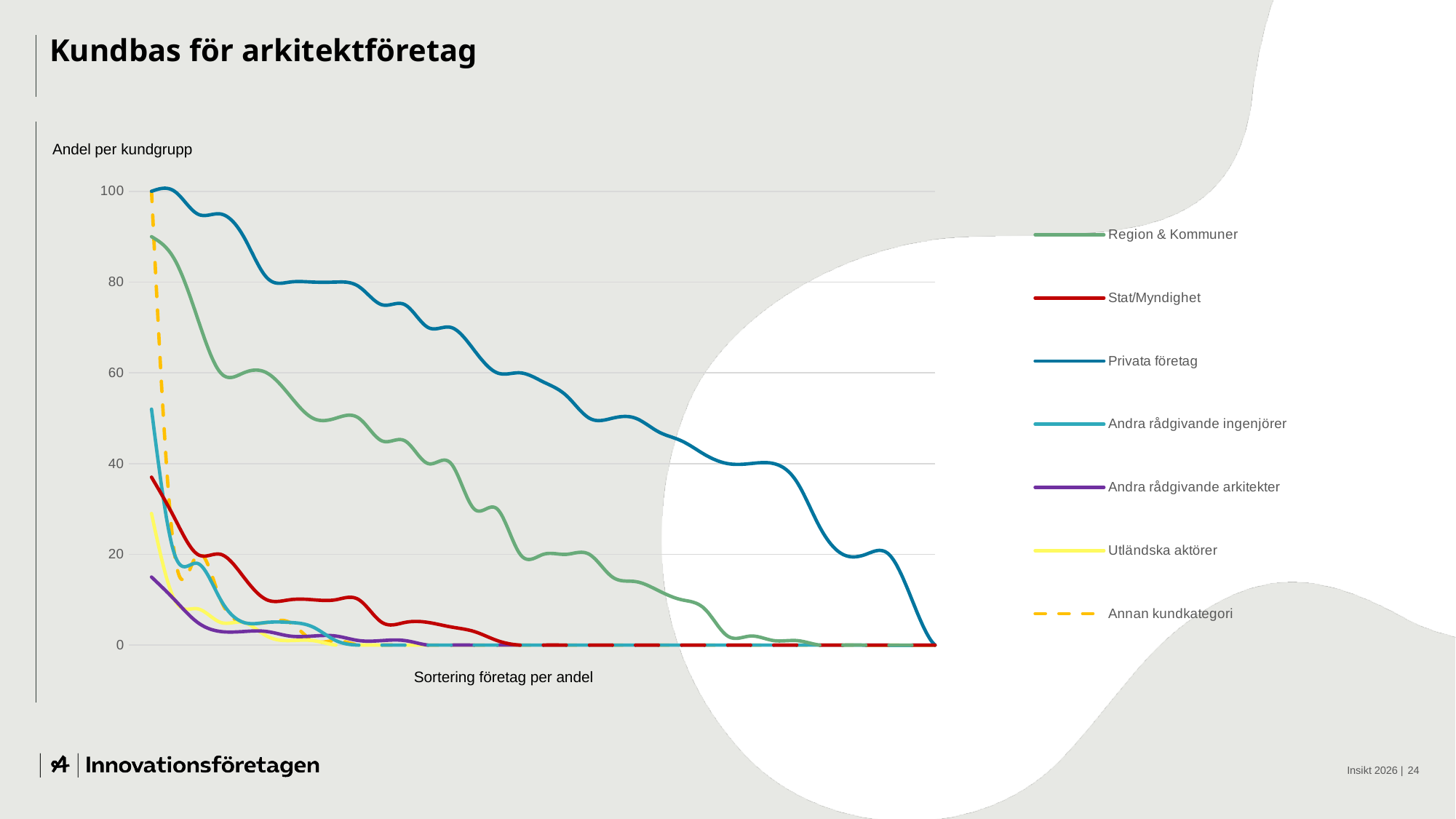
How many series does the legend list? 7 Do the values for Region & Kommuner rise or fall along the x axis? fall Is the starting value for Stat/Myndighet at the left of the chart greater or less than 40? less Is the starting value for Andra rådgivande arkitekter at the left of the chart greater or less than 20? less At the left edge of the chart, which is higher: Privata företag or Region & Kommuner? Privata företag What is the title of the slide's chart? Kundbas för arkitektföretag Is the starting value for Andra rådgivande ingenjörer at the left of the chart greater or less than 40? greater Do the values for Privata företag rise or fall along the x axis? fall What kind of chart is shown on the slide? line chart Which legend entry is drawn with a dashed line? Annan kundkategori At the left edge of the chart, which is higher: Stat/Myndighet or Andra rådgivande arkitekter? Stat/Myndighet